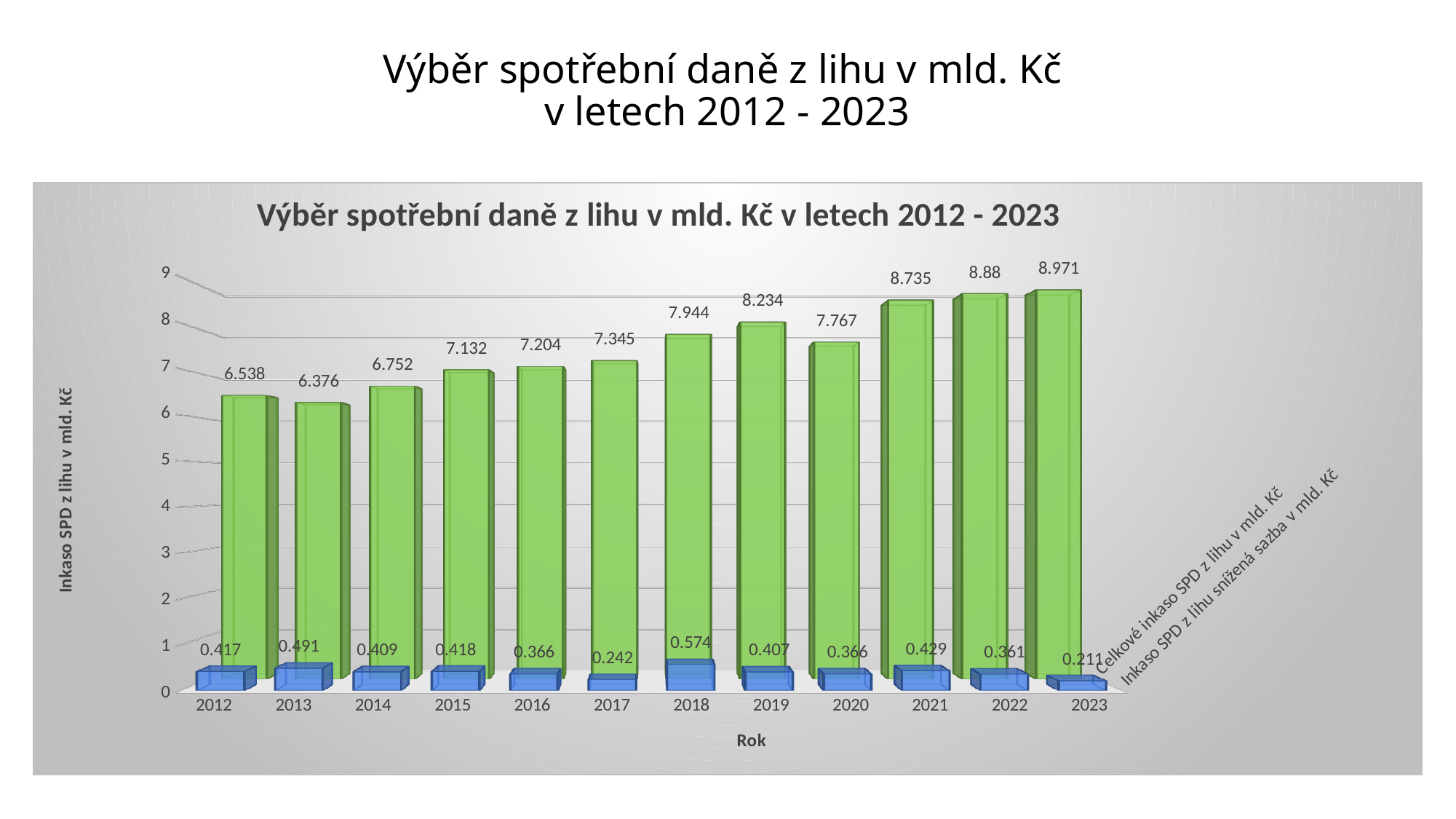
Which is larger: Celkové inkaso SPD z lihu v mld. Kč in 2019 or in 2020? 2019 What kind of chart is shown on the slide? bar chart Which year has the highest value of Celkové inkaso SPD z lihu v mld. Kč? 2023 Is the value of Celkové inkaso SPD z lihu v mld. Kč for 2015 greater or less than 7? greater What is the value of Celkové inkaso SPD z lihu v mld. Kč for 2023? 8.971 What is the value of Celkové inkaso SPD z lihu v mld. Kč for 2018? 7.944 Which year has the highest value of Inkaso SPD z lihu snížená sazba v mld. Kč? 2018 How many years are shown on the x axis? 12 Which year has the lowest value of Inkaso SPD z lihu snížená sazba v mld. Kč? 2023 What is the difference between Celkové inkaso SPD z lihu v mld. Kč in 2023 and in 2012? 2.433 What is the value of Inkaso SPD z lihu snížená sazba v mld. Kč for 2017? 0.242